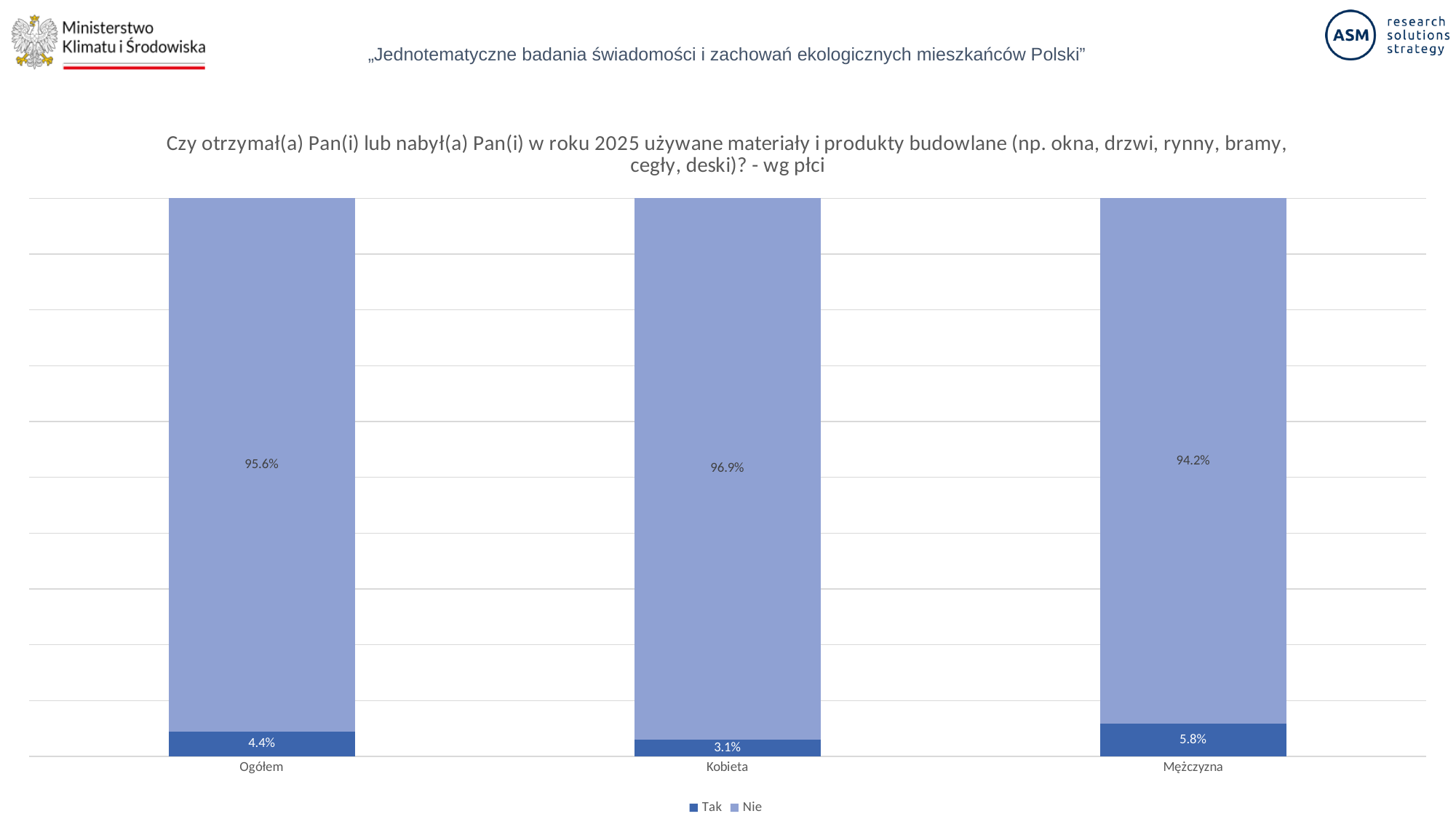
What is the difference between the "Tak" values for Mężczyzna and Kobieta? 2.7% What is the "Nie" value for Mężczyzna? 94.2% How many categories are shown on the x axis? 3 What is the "Tak" value for Mężczyzna? 5.8% What is the "Tak" value for Ogółem? 4.4% What kind of chart is shown on the slide? Stacked bar chart Which category has the highest "Tak" value? Mężczyzna Which is larger, the "Nie" value for Kobieta or for Ogółem? Kobieta What is the total of the stacked bar for Kobieta? 100% How many series does the legend list? 2 Which category has the lowest "Nie" value? Mężczyzna What is the "Nie" value for Kobieta? 96.9%